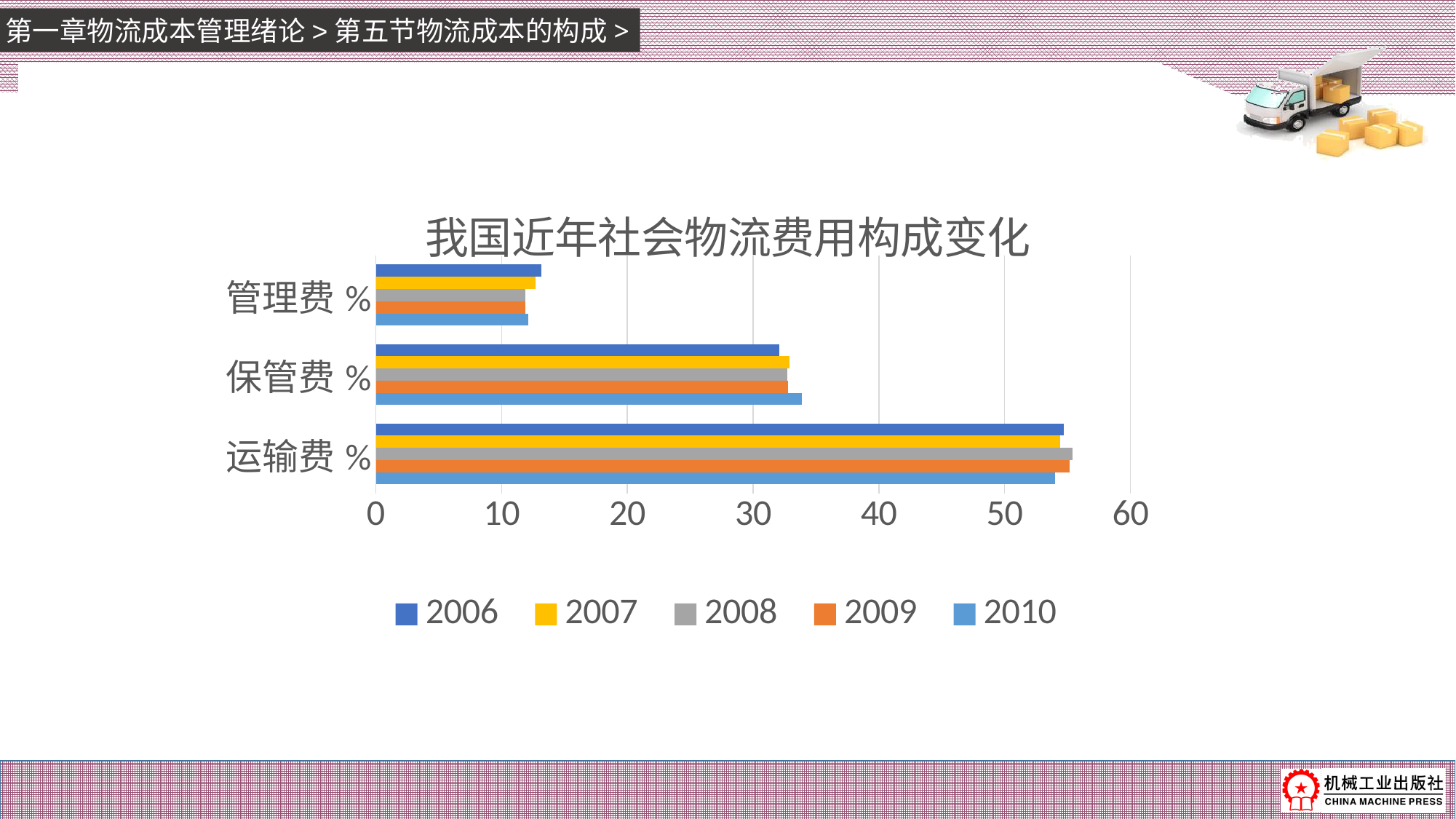
Is the 2009 value for 管理费 % greater or less than 10? greater What is the title of the chart? 我国近年社会物流费用构成变化 What kind of chart is shown on the slide? bar chart Which category has the lowest values across all years? 管理费 % Which category has the highest values across all years? 运输费 % Is the 2010 value for 运输费 % greater or less than 50? greater How many categories are shown on the vertical axis? 3 Is the 2010 value for 保管费 % greater or less than 30? greater How many series does the legend list? 5 Which is larger for 2008: 运输费 % or 保管费 %? 运输费 % Which year is shown first in the legend? 2006